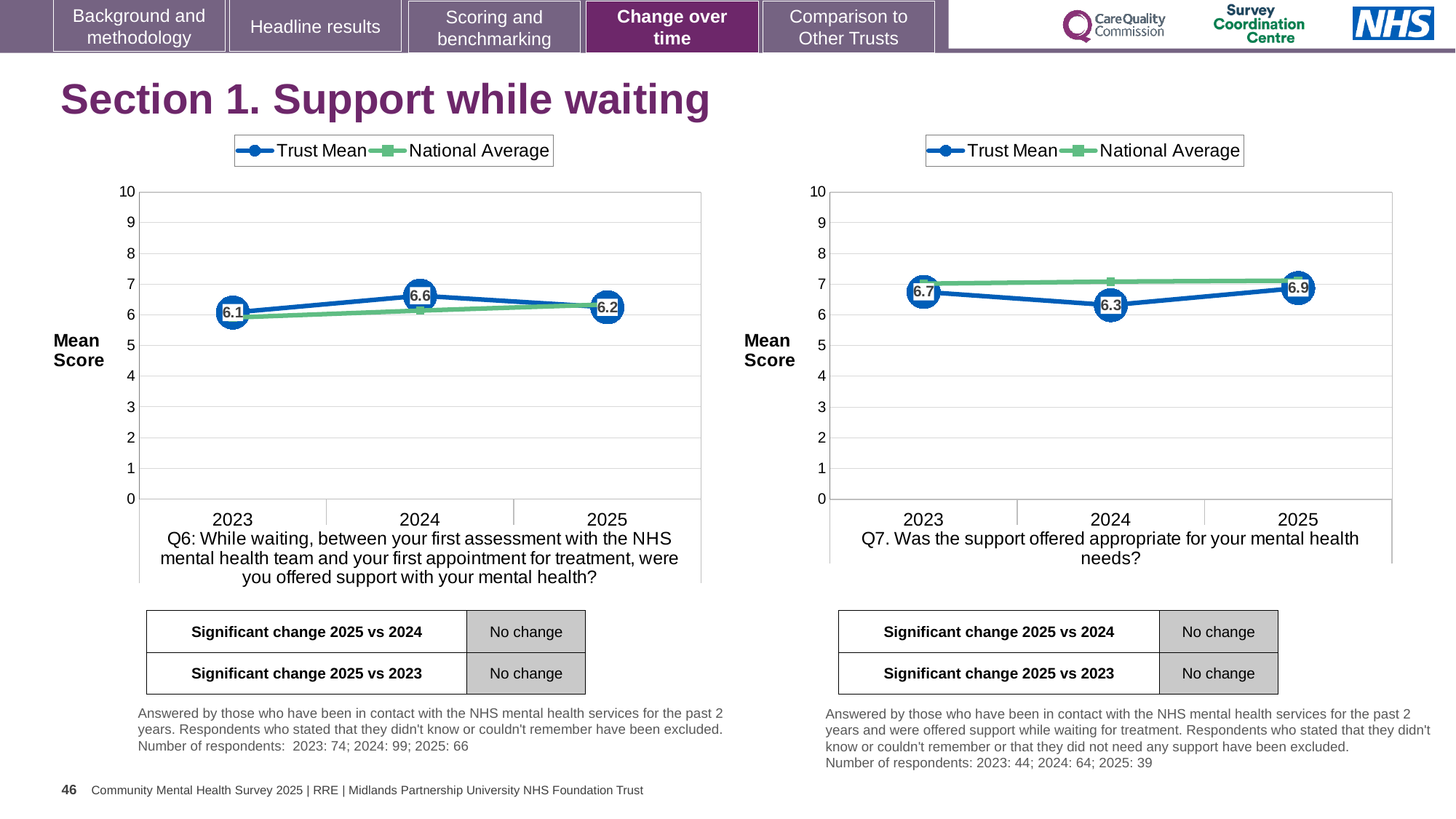
On the right chart (Q7), what is the Trust Mean score for 2024? 6.3 On the right chart (Q7), which is larger, the Trust Mean for 2023 or for 2025? 2025 On the left chart (Q6), which year has the highest Trust Mean score? 2024 On the right chart (Q7), what is the Trust Mean score for 2025? 6.9 On the left chart (Q6), what is the Trust Mean score for 2023? 6.1 What kind of chart is the left chart (Q6)? Line chart On the left chart (Q6), what is the difference between the Trust Mean scores for 2024 and 2025? 0.4 How many series does the legend of the left chart (Q6) list? 2 On the right chart (Q7), is the National Average value for 2024 greater or less than 6? greater On the left chart (Q6), what is the Trust Mean score for 2024? 6.6 How many years are plotted on the x axis of the right chart (Q7)? 3 On the right chart (Q7), which year has the lowest Trust Mean score? 2024